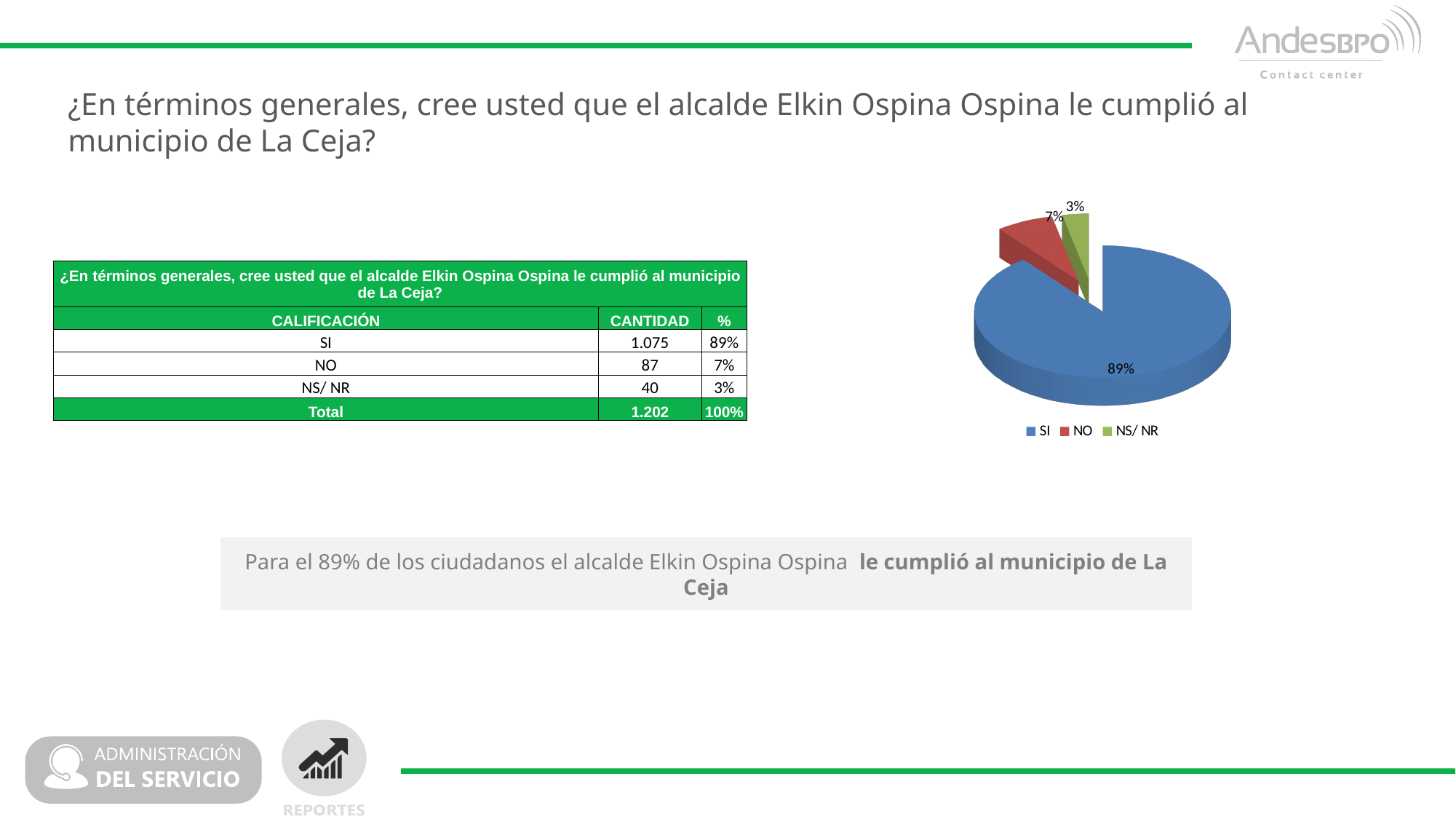
What share of the pie does the SI slice represent? 89% What kind of chart is shown on the slide? pie chart Which category has the largest slice of the pie? SI Which slice is larger, NO or NS/ NR? NO What share of the pie does the NS/ NR slice represent? 3% What colour is the SI slice in the pie chart? blue What is the difference in percentage points between the SI slice and the NO slice? 82% What colour is the NO slice in the pie chart? red How many slices does the pie chart have? 3 How many entries does the legend of the pie chart list? 3 Which category has the smallest slice of the pie? NS/ NR What share of the pie does the NO slice represent? 7%